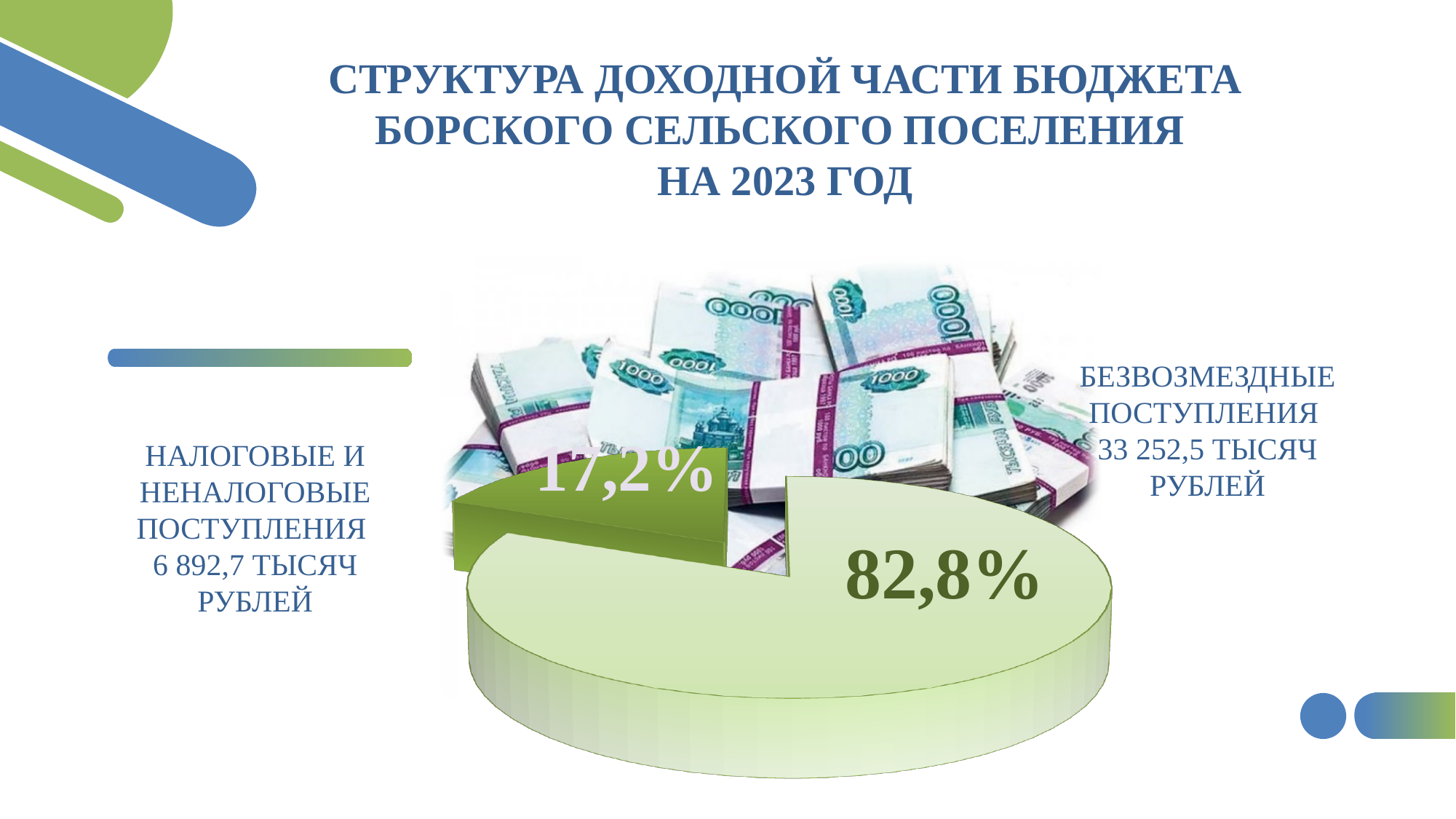
What share of the pie is labelled for БЕЗВОЗМЕЗДНЫЕ ПОСТУПЛЕНИЯ? 82,8% What amount in thousand rubles is given for БЕЗВОЗМЕЗДНЫЕ ПОСТУПЛЕНИЯ? 33 252,5 What share of the pie is labelled for НАЛОГОВЫЕ И НЕНАЛОГОВЫЕ ПОСТУПЛЕНИЯ? 17,2% Which category has the smallest slice of the pie? НАЛОГОВЫЕ И НЕНАЛОГОВЫЕ ПОСТУПЛЕНИЯ How many slices does the pie chart have? 2 Which is larger: the share for БЕЗВОЗМЕЗДНЫЕ ПОСТУПЛЕНИЯ or the share for НАЛОГОВЫЕ И НЕНАЛОГОВЫЕ ПОСТУПЛЕНИЯ? БЕЗВОЗМЕЗДНЫЕ ПОСТУПЛЕНИЯ For which year does the chart show the budget revenue structure? 2023 What is the difference in percentage points between the 82,8% slice and the 17,2% slice? 65,6 What is the difference in thousand rubles between БЕЗВОЗМЕЗДНЫЕ ПОСТУПЛЕНИЯ and НАЛОГОВЫЕ И НЕНАЛОГОВЫЕ ПОСТУПЛЕНИЯ? 26 359,8 What amount in thousand rubles is given for НАЛОГОВЫЕ И НЕНАЛОГОВЫЕ ПОСТУПЛЕНИЯ? 6 892,7 Which category has the largest slice of the pie? БЕЗВОЗМЕЗДНЫЕ ПОСТУПЛЕНИЯ What kind of chart is shown on the slide? pie chart